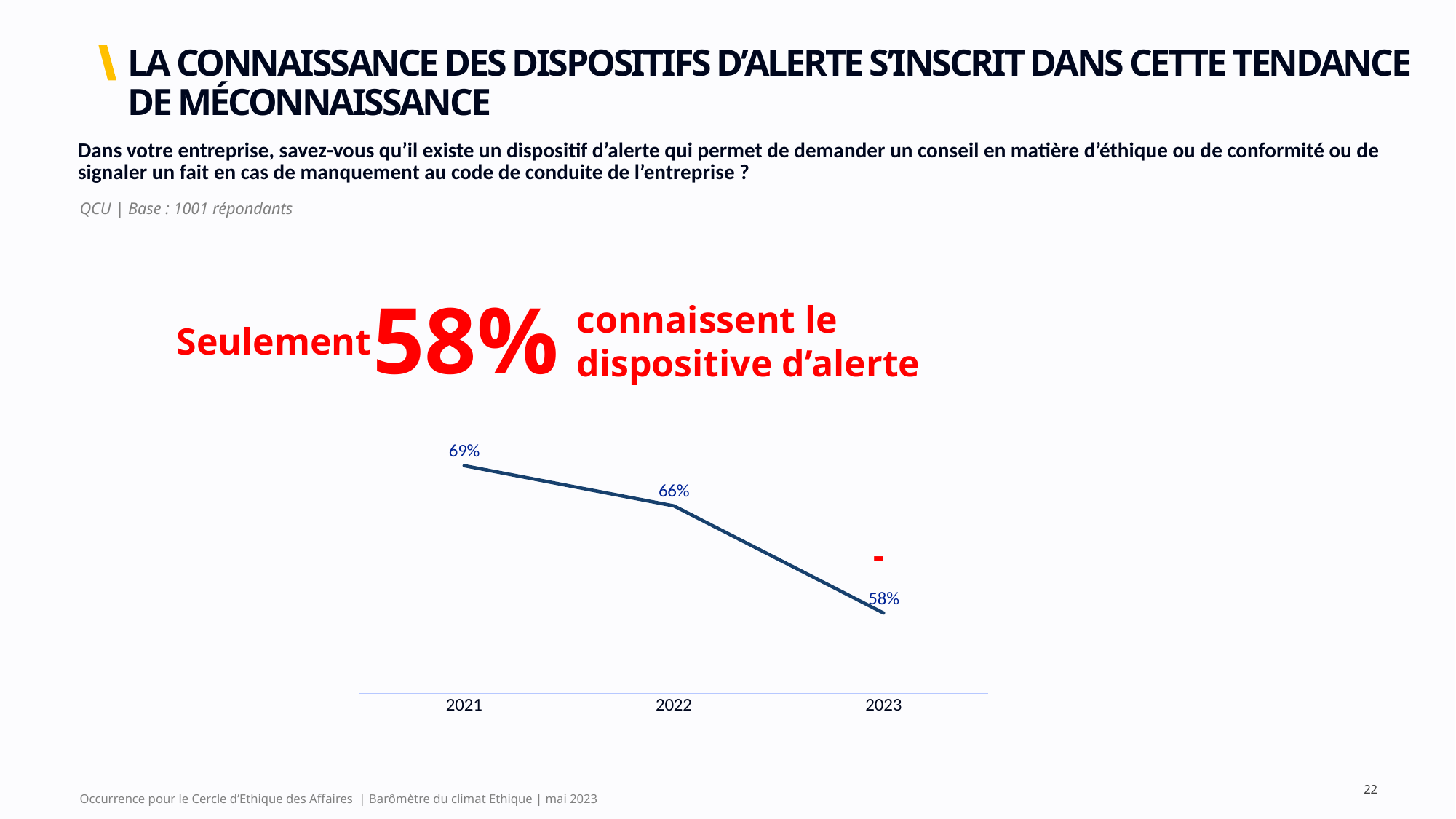
What is the value for 2023? 58% What is the difference between the values for 2021 and 2023? 11 percentage points What kind of chart is shown on the slide? Line chart How many years are plotted on the chart? 3 Which year has the lowest value? 2023 What is the difference between the values for 2022 and 2023? 8 percentage points Which is larger, the value for 2021 or the value for 2022? 2021 What is the value for 2022? 66% What is the value for 2021? 69% Do the values rise or fall from 2021 to 2023? Fall Which year has the highest value? 2021 What percentage is highlighted in large red text above the chart? 58%